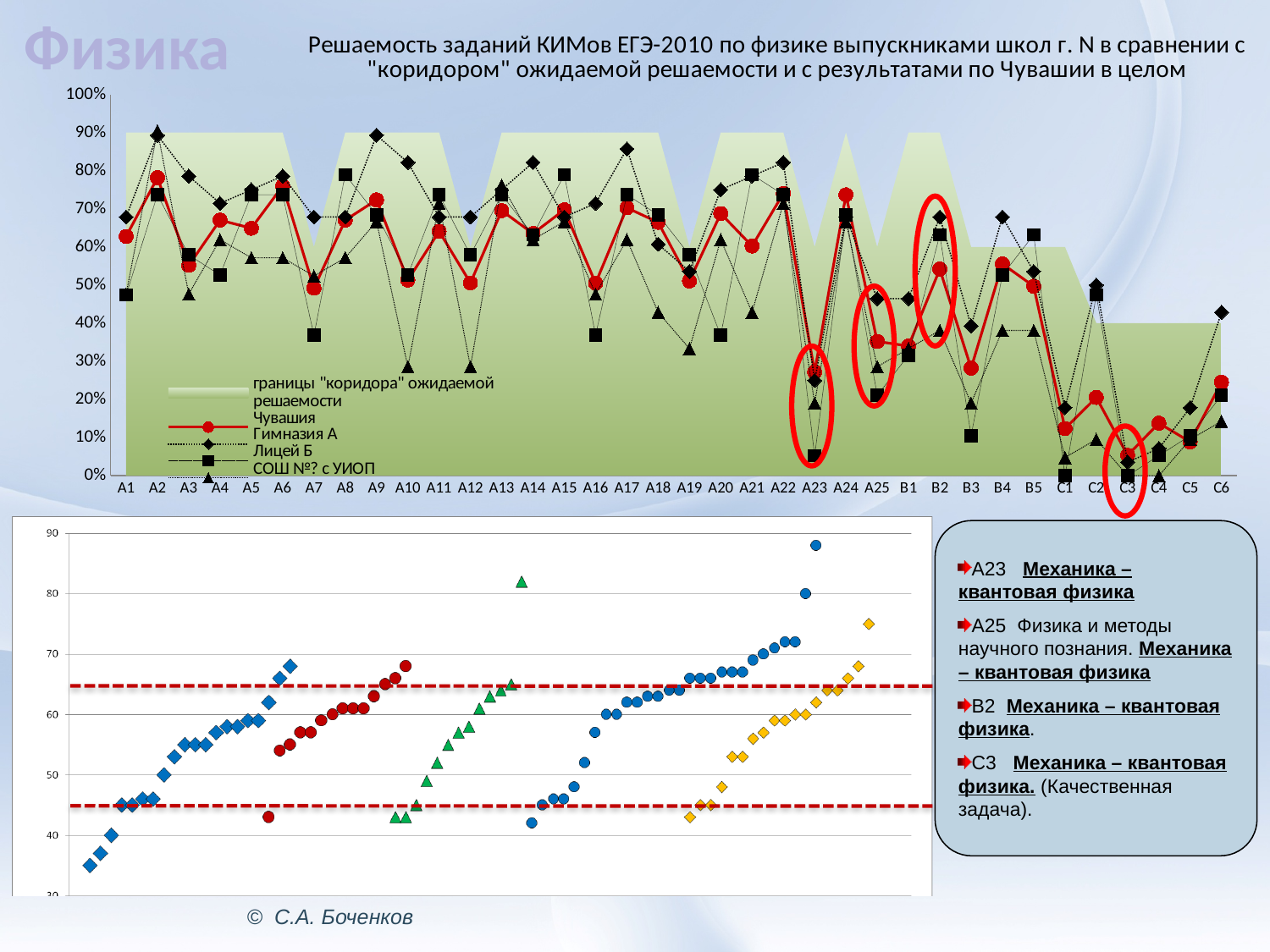
In the top chart, is the value for Лицей Б at A9 greater or less than 80%? less In the top chart, which is larger for Чувашия: the value at A2 or at A3? A2 In the top chart, what does the shaded green area represent according to the legend? границы "коридора" ожидаемой решаемости In the top chart, how many series does the legend list? 5 What kind of chart is the top chart on the slide? line chart In the top chart, is the value for Чувашия at A23 greater or less than 40%? less In the top chart, which is larger for Чувашия: the value at C6 or at C3? C6 In the top chart, at which category is the Чувашия series lowest? C3 In the top chart, how many task categories are shown along the x axis? 36 What kind of chart is the bottom chart on the slide? scatter chart In the top chart, is the value for Чувашия at A2 greater or less than 70%? greater